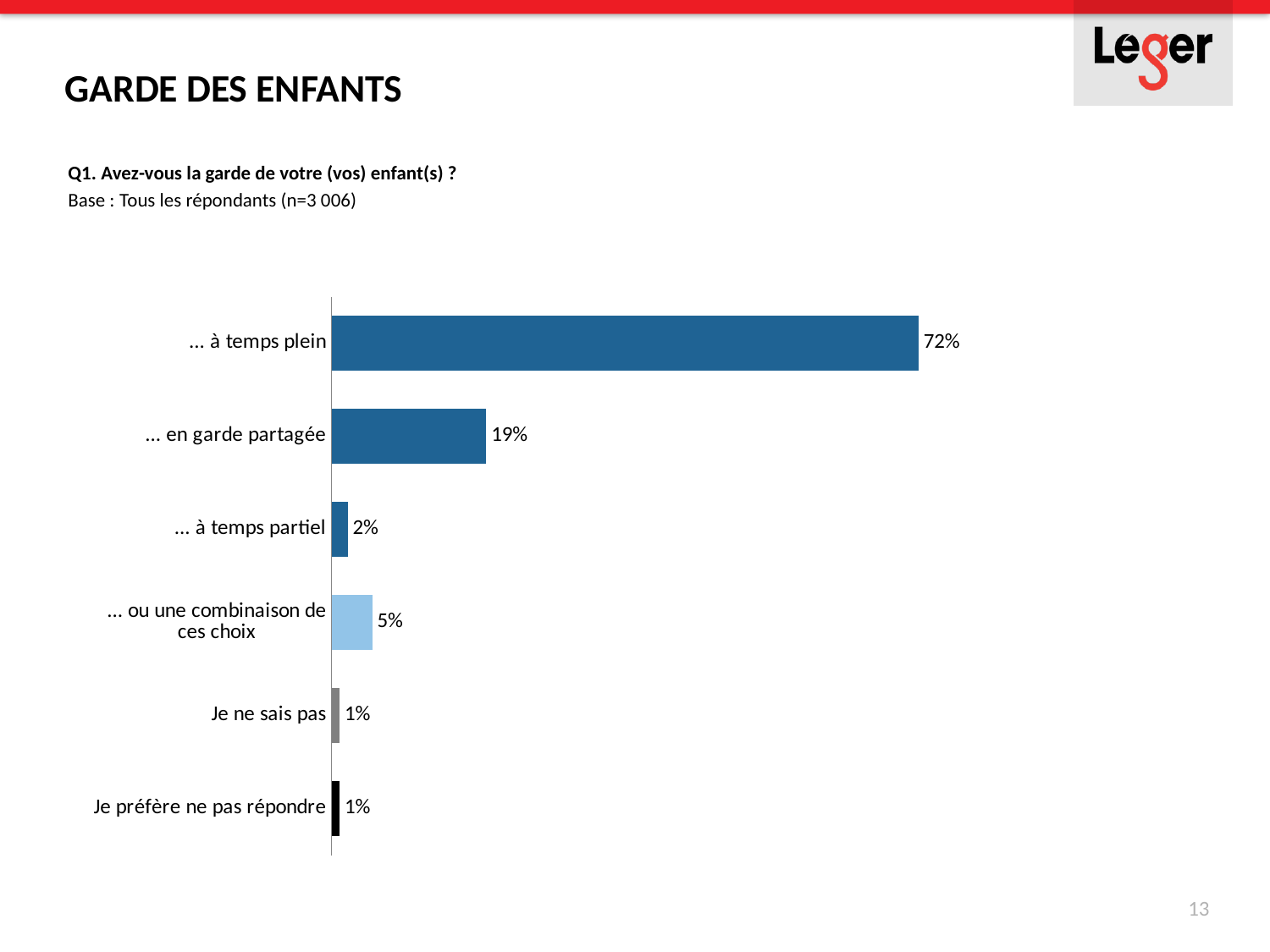
Which is larger: the value for "... à temps partiel" or the value for "... ou une combinaison de ces choix"? ... ou une combinaison de ces choix What is the difference between the values for "... à temps plein" and "... en garde partagée"? 53 percentage points Which category has the highest value? ... à temps plein What is the value shown for "Je ne sais pas"? 1% What is the value shown for "... en garde partagée"? 19% What percentage of respondents have custody of their child(ren) full time ("... à temps plein")? 72% What is the base (number of respondents) stated for this question? n=3 006 How many categories are shown in the chart? 6 What is the value shown for "... à temps partiel"? 2% What is the title of the slide? GARDE DES ENFANTS What is the value shown for "... ou une combinaison de ces choix"? 5% What kind of chart is shown on the slide? Bar chart